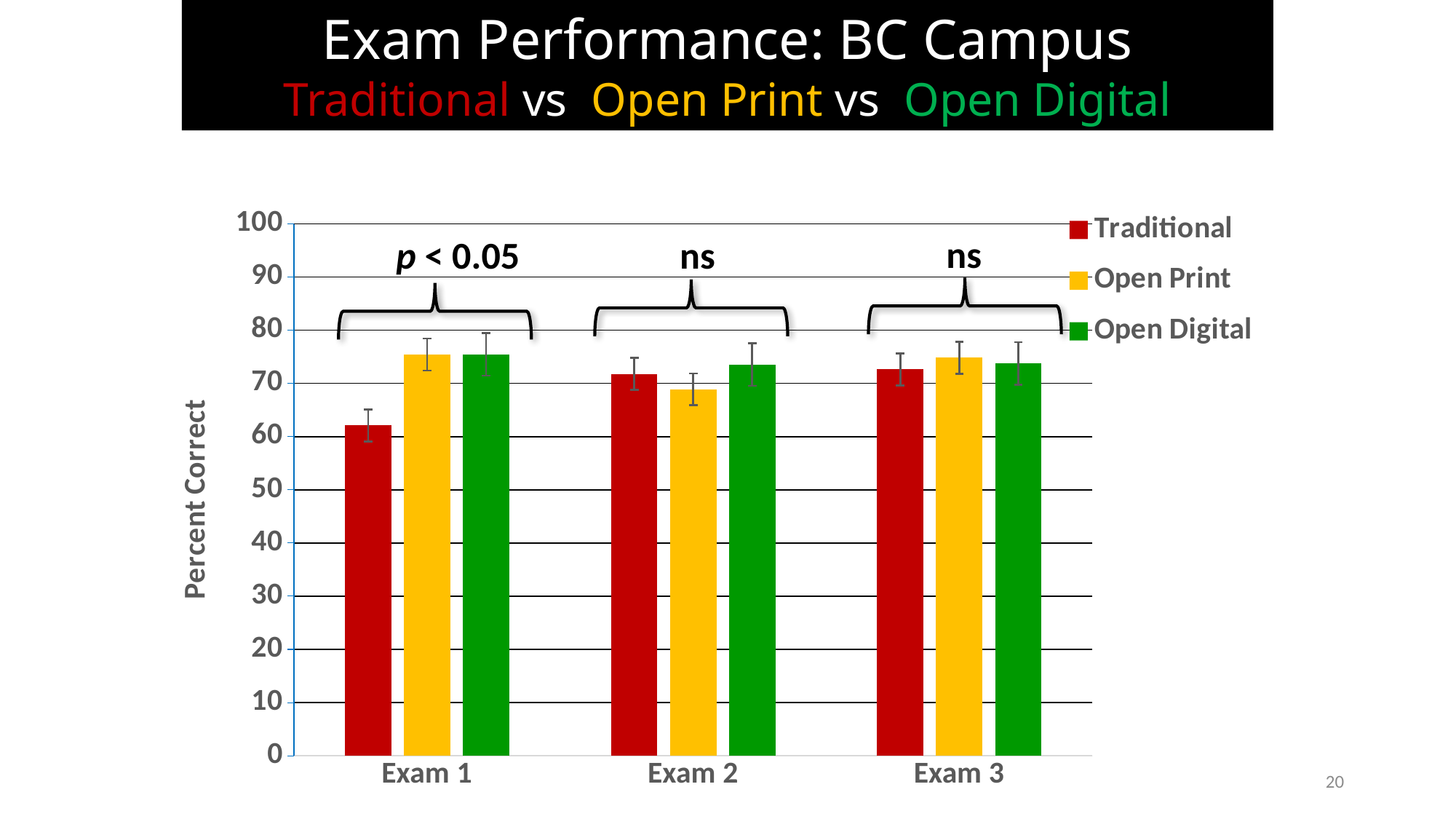
For Exam 2, which is larger: the Traditional value or the Open Print value? Traditional Is the Open Print value for Exam 1 greater or less than 70? greater What is the label on the vertical axis? Percent Correct How many series does the legend list? 3 Is the Traditional value for Exam 1 greater or less than 70? less Which series has the lowest value for Exam 2? Open Print Which series has the lowest value for Exam 1? Traditional How many exam categories are shown on the x axis? 3 Is the Open Digital value for Exam 3 greater or less than 70? greater What kind of chart is shown on the slide? bar chart For Exam 1, which is larger: the Traditional value or the Open Print value? Open Print